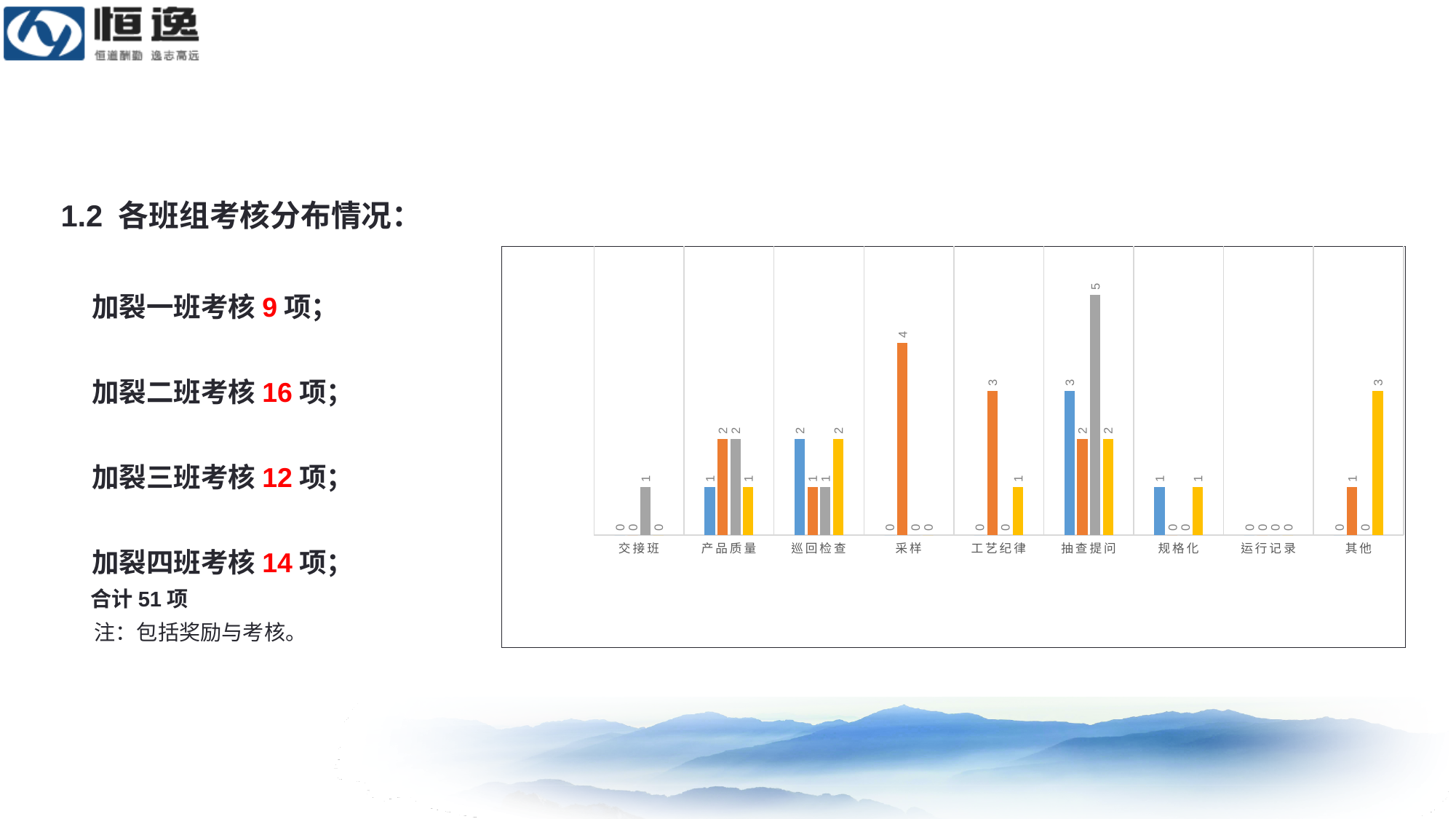
What is the value of the yellow bar for 其他? 3 What is the value of the blue bar for 巡回检查? 2 What is the value of the orange bar for 采样? 4 Which category has all four bars equal to 0? 运行记录 What kind of chart is shown on the slide? bar chart What is the difference between the gray bar for 抽查提问 and the orange bar for 采样? 1 How many differently coloured bar series are plotted for each category? 4 What is the value of the gray bar for 抽查提问? 5 Which category contains the tallest bar in the chart? 抽查提问 How many categories are shown along the x axis of the chart? 9 Which is larger: the orange bar for 工艺纪律 or the yellow bar for 工艺纪律? the orange bar for 工艺纪律 What is the sum of the four bars for 产品质量? 6